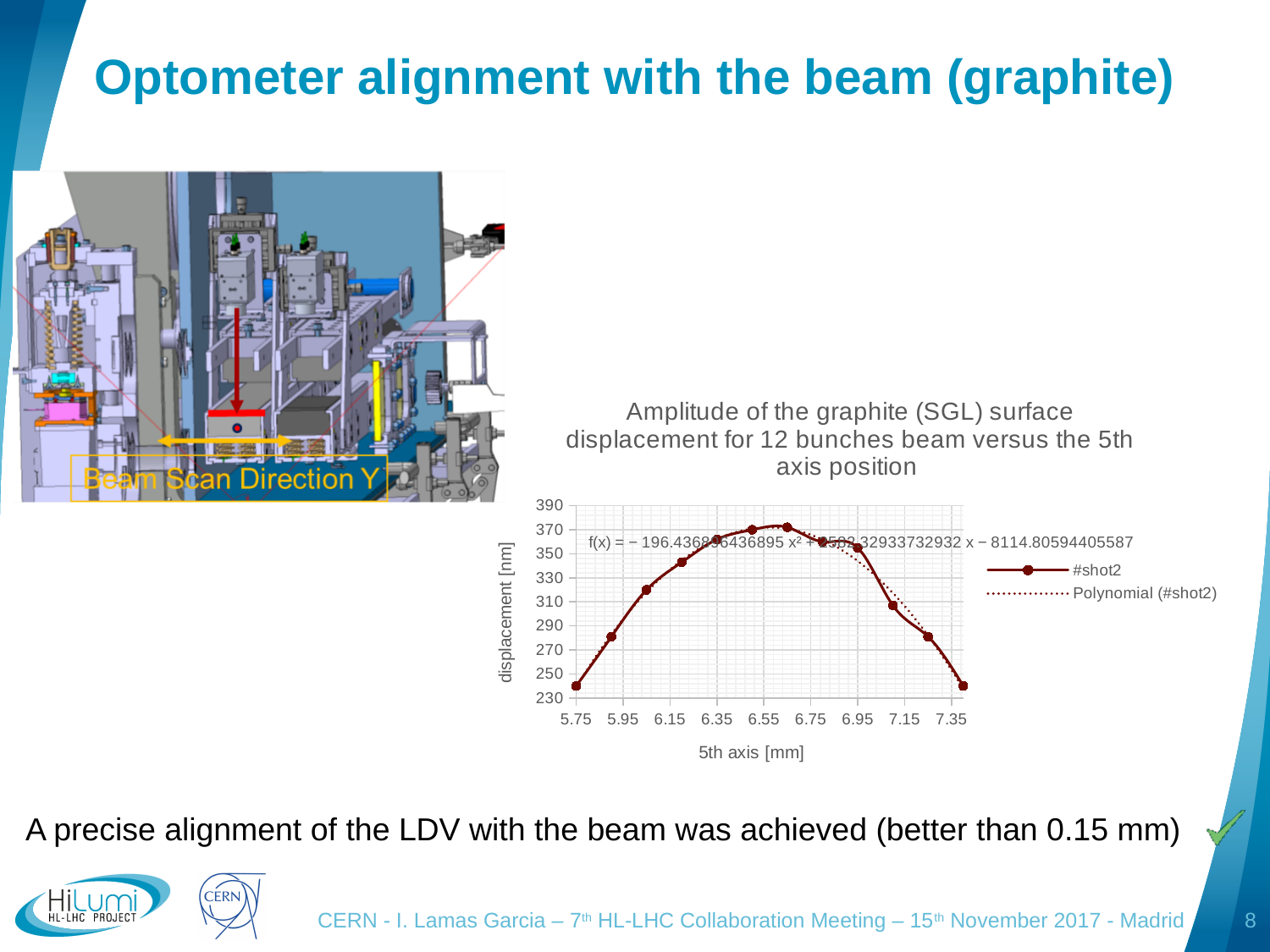
How many series does the chart legend list? 2 Does the #shot2 displacement rise or fall as the 5th axis position increases from 5.75 mm to 6.35 mm? rise Is the displacement value at the 5th axis position 5.75 mm greater or less than 250? less What is the lowest value shown on the chart's y axis? 230 Which is larger: the displacement at 5th axis position 5.75 mm or the displacement at 6.55 mm? 6.55 mm Is the highest displacement value on the #shot2 curve greater or less than 350? greater What kind of chart is shown on the slide? line chart Is the highest displacement value on the #shot2 curve greater or less than 390? less Does the #shot2 displacement rise or fall as the 5th axis position increases from 6.95 mm to 7.35 mm? fall What are the two entries in the chart legend? #shot2 and Polynomial (#shot2) What is the label of the chart's y axis? displacement [nm]